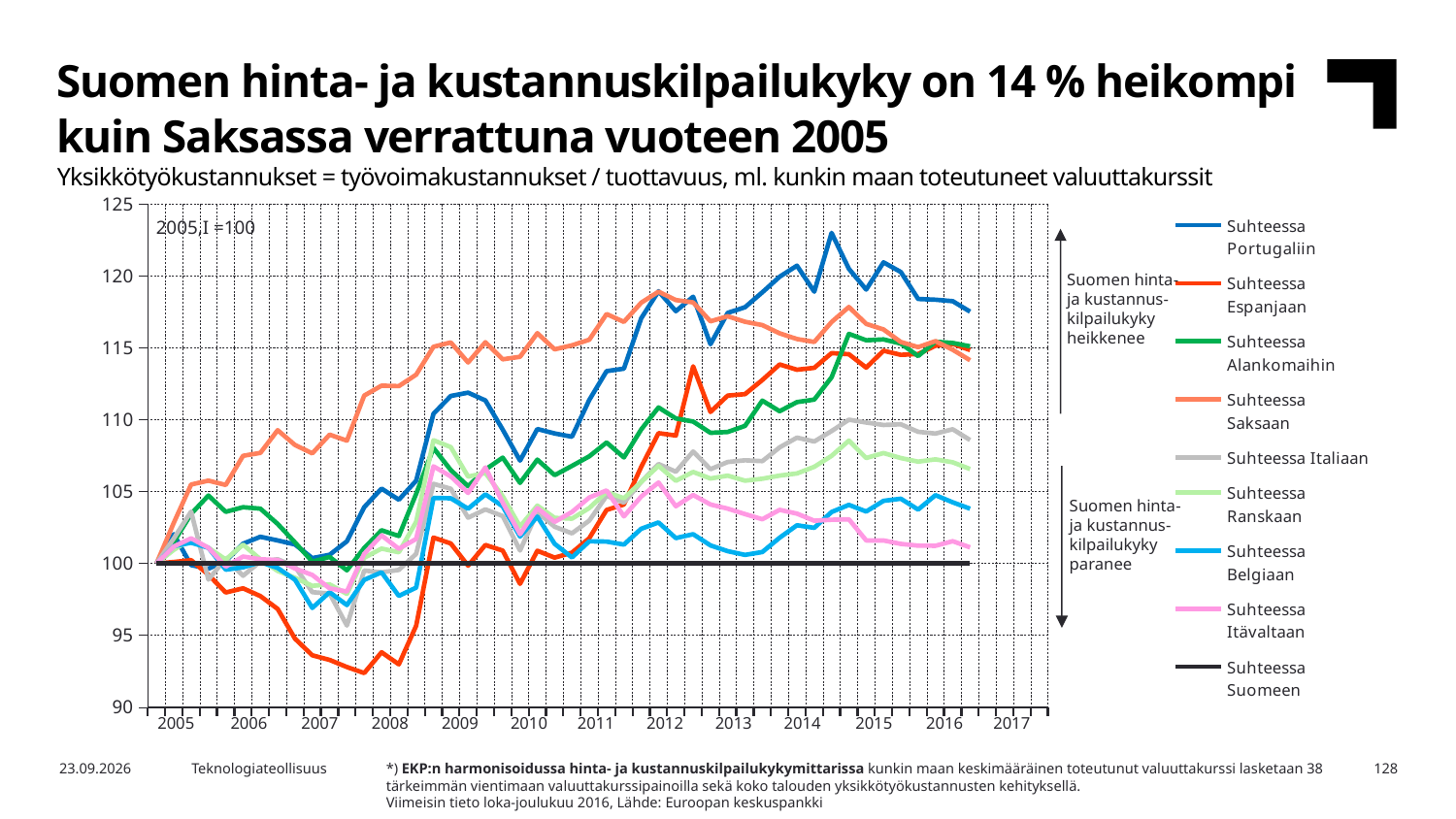
Does the Suhteessa Portugaliin line overall rise or fall from 2005 to 2016? rise How many series does the legend list? 9 Is the peak value of the Suhteessa Portugaliin line greater or less than 120? greater Is the lowest value of the Suhteessa Espanjaan line (around 2007–2008) greater or less than 95? less What kind of chart is shown on the slide? line chart Which series falls to the lowest value anywhere on the chart? Suhteessa Espanjaan Is the value of the Suhteessa Belgiaan line at the end of 2016 greater or less than 100? greater What base value is stated for 2005,I in the chart? 100 Which series reaches the highest value anywhere on the chart? Suhteessa Portugaliin How many year labels are shown on the x axis? 13 At the end of 2016, which is higher: the Suhteessa Portugaliin line or the Suhteessa Belgiaan line? Suhteessa Portugaliin Which series is drawn as a flat horizontal line at 100 throughout the chart? Suhteessa Suomeen